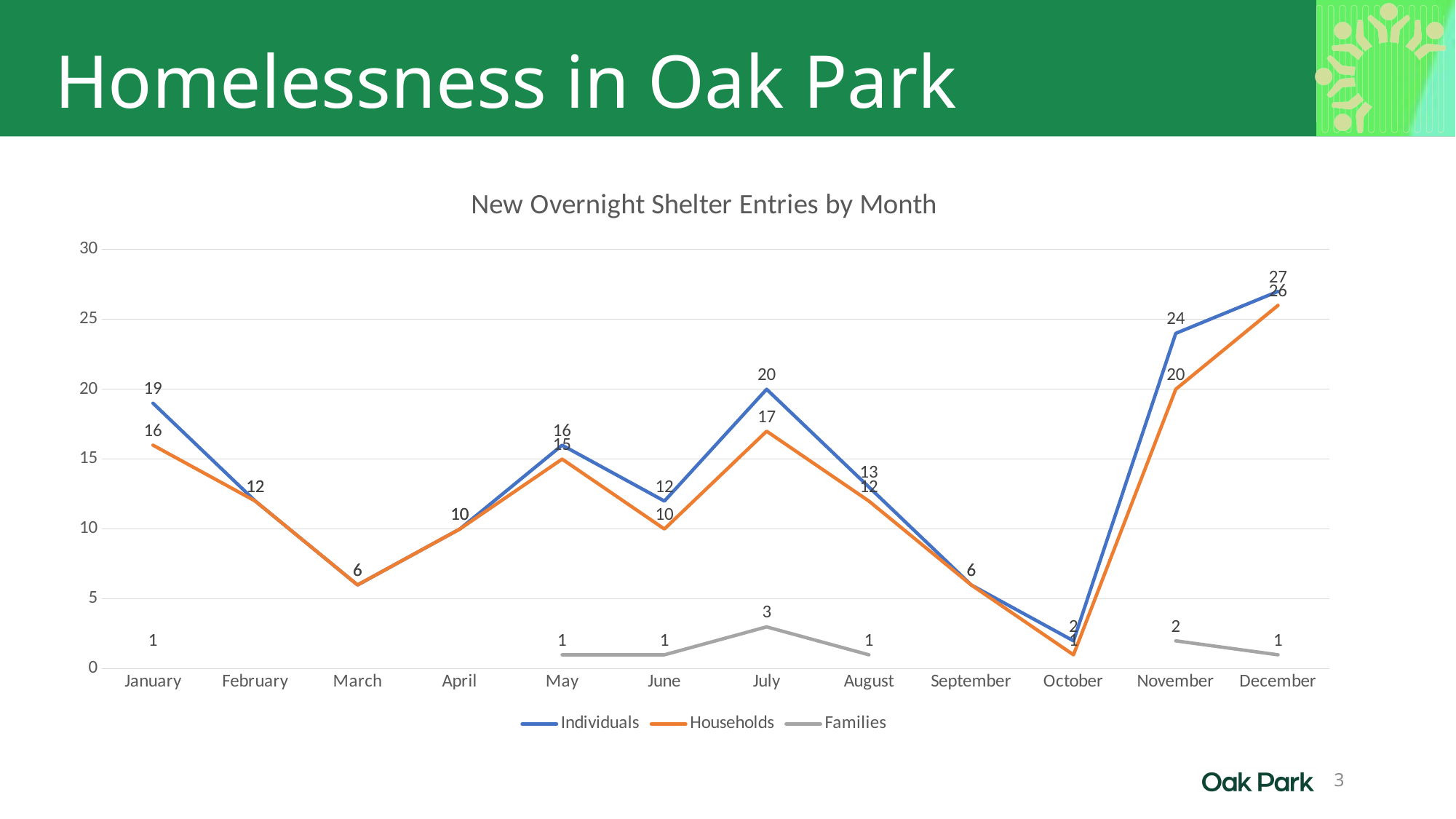
What kind of chart is shown on the slide? line chart How many series does the legend list? 3 In which month is the Individuals series lowest? October What is the value for Families in July? 3 In which month is the Individuals series highest? December What is the value for Individuals in July? 20 What is the value for Households in December? 26 What is the difference between Individuals and Households in November? 4 Which is larger for Individuals: January or July? July How many months are plotted along the x axis? 12 What is the title of the chart? New Overnight Shelter Entries by Month What is the value for Households in November? 20